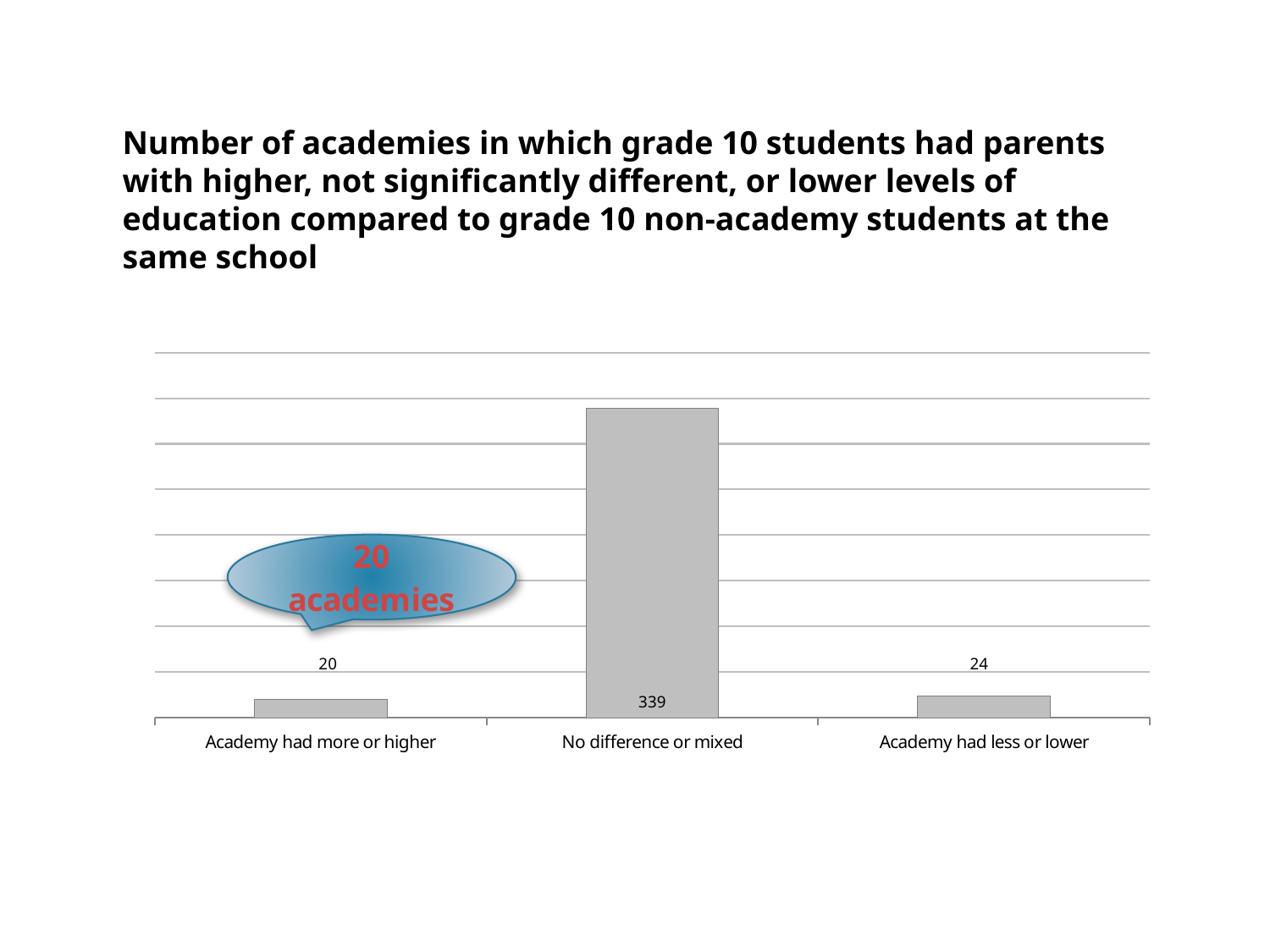
Which category has the lowest value? Academy had more or higher Which category has the highest value? No difference or mixed What is the difference between the values for 'Academy had less or lower' and 'Academy had more or higher'? 4 How many categories are shown on the x axis? 3 What kind of chart is shown on the slide? Bar chart What is the value for 'No difference or mixed'? 339 What is the difference between the values for 'No difference or mixed' and 'Academy had less or lower'? 315 Which is larger, the value for 'Academy had less or lower' or the value for 'Academy had more or higher'? Academy had less or lower What is the value for 'Academy had less or lower'? 24 What is the value for 'Academy had more or higher'? 20 What text appears in the blue callout shape on the chart? 20 academies What is the total of the three values shown in the chart? 383